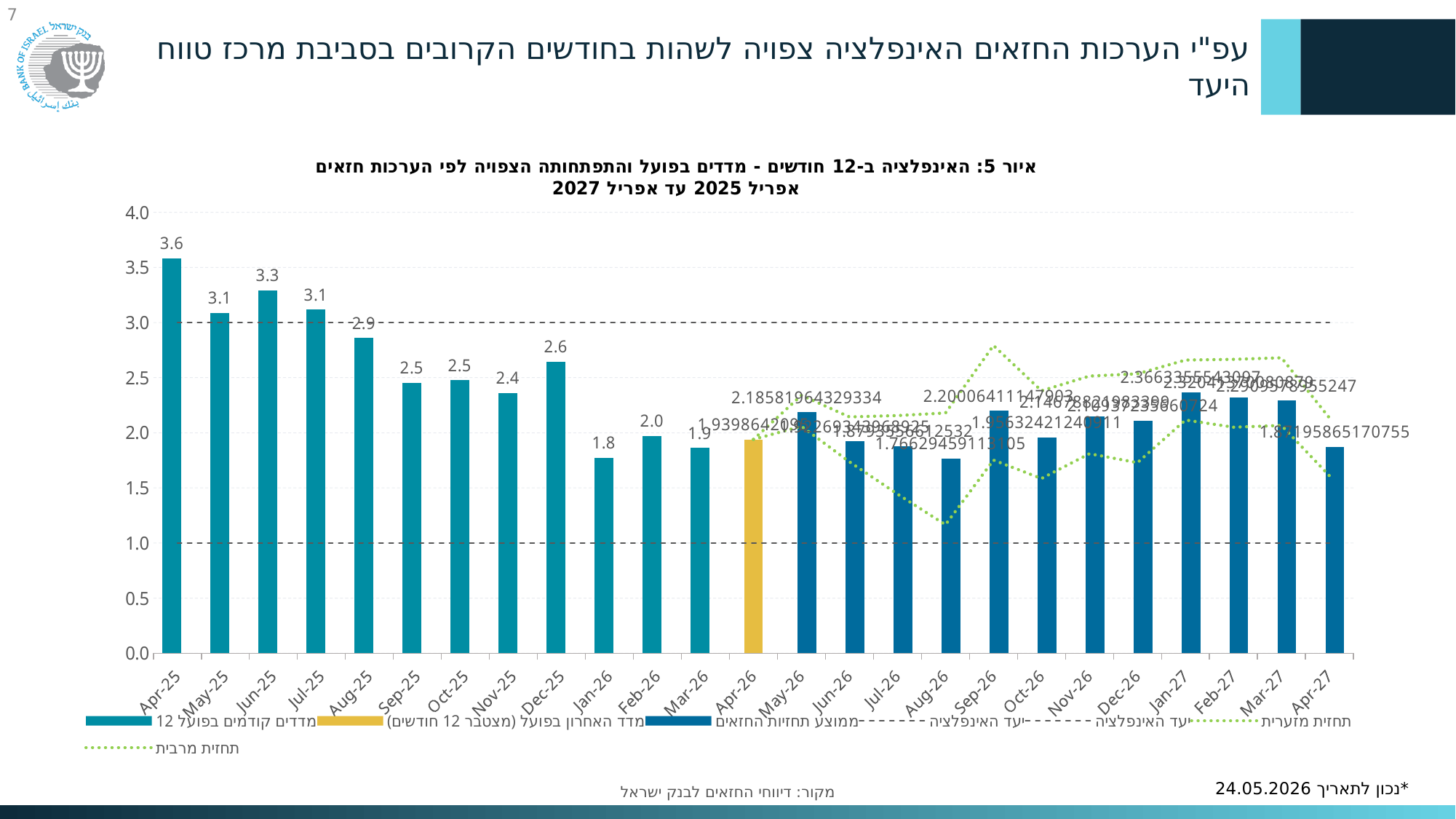
Which is larger, the value for Nov-25 or the value for Dec-25? Dec-25 Do the values rise or fall from Apr-25 to Jan-26? fall What is the value for Dec-25? 2.6 Which month has the highest value in the chart? Apr-25 Which of the 2025 months (Apr-25 to Dec-25) has the lowest value? Nov-25 What is the value for Jun-25? 3.3 Which month's bar is coloured yellow? Apr-26 Is the value for Apr-27 greater or less than 2.0? less What is the value for Apr-25? 3.6 How many months (bars) are shown on the x axis? 25 What is the difference between the values for Apr-25 and Jan-26? 1.8 What is the value for Jan-26? 1.8